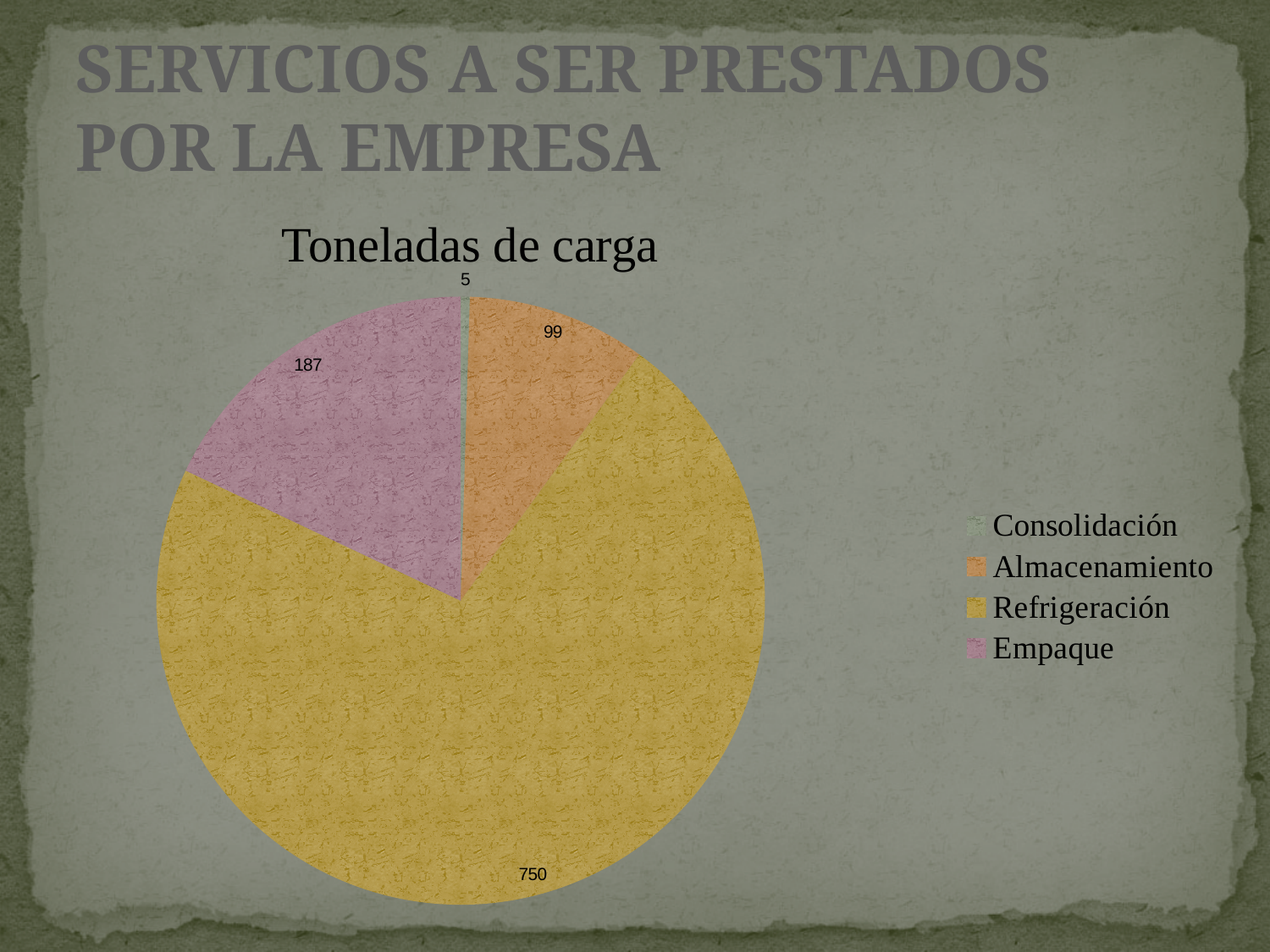
What is the title of the chart? Toneladas de carga What is the value for Consolidación? 5 What is the difference between the values for Refrigeración and Empaque? 563 What type of chart is shown on the slide? pie chart What is the value for Refrigeración? 750 Which is larger, the value for Empaque or the value for Almacenamiento? Empaque Which category has the largest slice of the pie? Refrigeración What is the total of all the slices in the pie chart? 1041 What is the value for Almacenamiento? 99 Which category has the smallest slice of the pie? Consolidación What is the value for Empaque? 187 How many categories does the pie chart have? 4